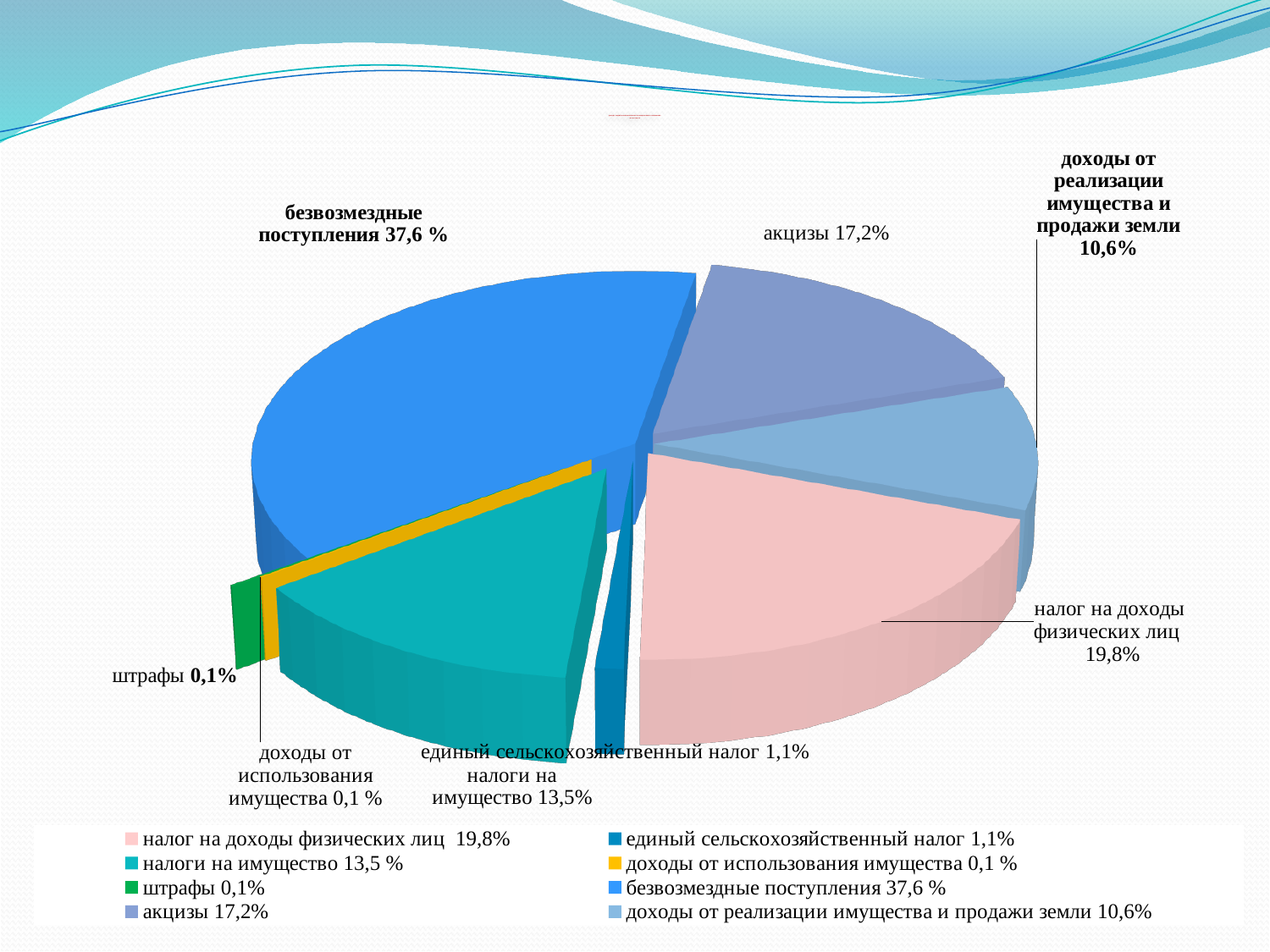
What share of the pie does безвозмездные поступления have? 37,6 % What is the value shown for доходы от реализации имущества и продажи земли? 10,6% What is the value shown for акцизы? 17,2% What colour is the slice for штрафы? green What is the difference between the shares of налог на доходы физических лиц and налоги на имущество? 6,3% Which category has the largest share of the pie? безвозмездные поступления Which is larger, the share for акцизы or the share for доходы от реализации имущества и продажи земли? акцизы How many slices does the pie chart have? 8 What is the value shown for налог на доходы физических лиц? 19,8% How many entries does the legend list? 8 What is the value shown for единый сельскохозяйственный налог? 1,1% What kind of chart is shown on the slide? pie chart